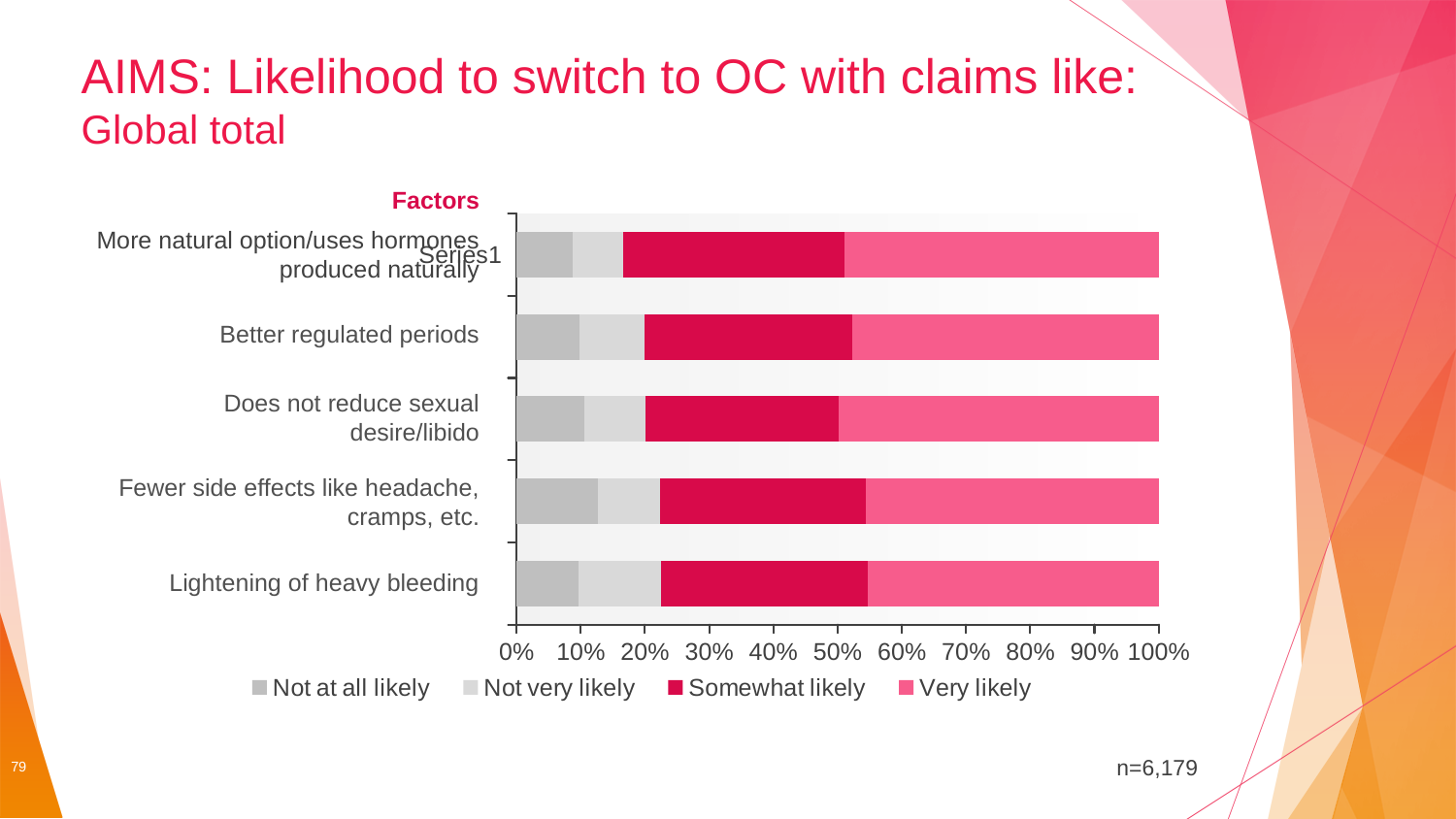
What is the highest value shown on the horizontal axis of the chart? 100% What sample size is stated below the chart? n=6,179 Is the cumulative share up to and including 'Somewhat likely' for 'Fewer side effects like headache, cramps, etc.' greater or less than 50%? greater How many series does the chart legend list? 4 Which is larger: the 'Not at all likely' segment for 'Fewer side effects like headache, cramps, etc.' or for 'More natural option/uses hormones produced naturally'? Fewer side effects like headache, cramps, etc. Is the combined 'Not at all likely' and 'Not very likely' share for 'Lightening of heavy bleeding' greater or less than 20%? greater Is the combined 'Not at all likely' and 'Not very likely' share for 'More natural option/uses hormones produced naturally' greater or less than 20%? less How many factors (categories) are plotted in the chart? 5 What kind of chart is shown on the slide? Stacked bar chart What are the four legend entries in the chart? Not at all likely, Not very likely, Somewhat likely, Very likely Which factor has the largest 'Not at all likely' segment? Fewer side effects like headache, cramps, etc.